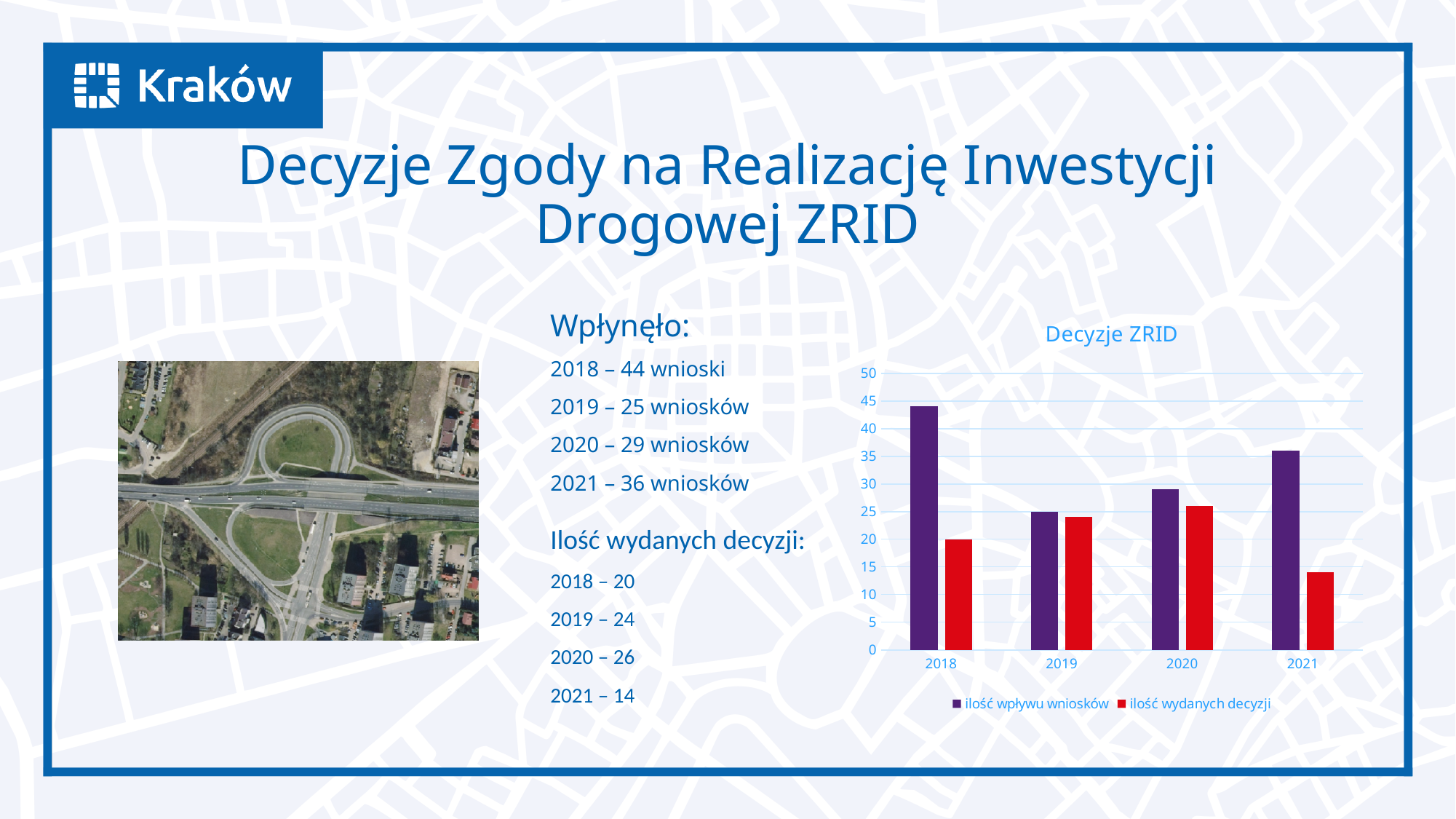
What is the value of "ilość wydanych decyzji" for 2019 in the "Decyzje ZRID" chart? 24 What is the value of "ilość wpływu wniosków" for 2021 in the "Decyzje ZRID" chart? 36 In the "Decyzje ZRID" chart, what is the difference between "ilość wpływu wniosków" and "ilość wydanych decyzji" in 2018? 24 What colour are the "ilość wydanych decyzji" bars in the "Decyzje ZRID" chart? red How many years are shown on the x axis of the "Decyzje ZRID" chart? 4 How many series does the legend of the "Decyzje ZRID" chart list? 2 In the "Decyzje ZRID" chart, which is larger in 2020: "ilość wpływu wniosków" or "ilość wydanych decyzji"? ilość wpływu wniosków In the "Decyzje ZRID" chart, is the value for "ilość wpływu wniosków" in 2018 greater or less than 40? greater In the "Decyzje ZRID" chart, which year has the lowest value for "ilość wydanych decyzji"? 2021 In the "Decyzje ZRID" chart, which year has the highest value for "ilość wpływu wniosków"? 2018 What kind of chart is "Decyzje ZRID"? bar chart In the "Decyzje ZRID" chart, is the value for "ilość wydanych decyzji" in 2021 greater or less than 15? less